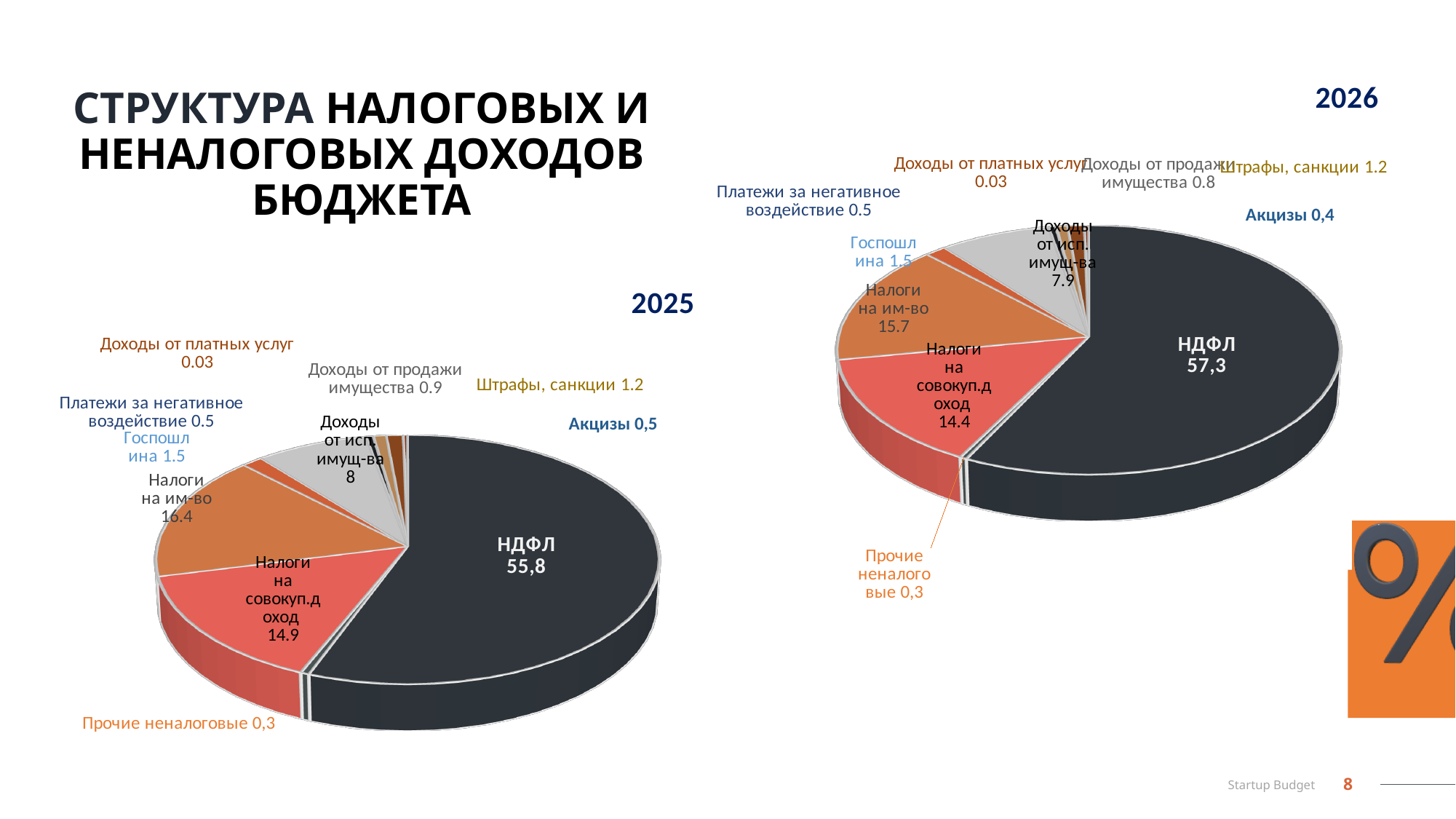
In the 2026 chart, what is the value for Акцизы? 0,4 In the 2025 chart, what is the value for Налоги на им-во? 16.4 In the 2026 chart, what is the value for НДФЛ? 57,3 In the 2025 chart, which category has the largest slice? НДФЛ In the 2025 chart, what is the value for НДФЛ? 55,8 How many categories are shown in the 2025 pie chart? 11 In the 2026 chart, which is larger: Налоги на им-во or Налоги на совокуп.доход? Налоги на им-во In the 2025 chart, what is the difference between Налоги на им-во and Налоги на совокуп.доход? 1.5 In the 2025 chart, what is the value for Доходы от исп. имущ-ва? 8 In the 2026 chart, which category has the smallest value? Доходы от платных услуг In the 2026 chart, what is the value for Налоги на совокуп.доход? 14.4 What kind of chart is used for the 2025 data on the slide? Pie chart